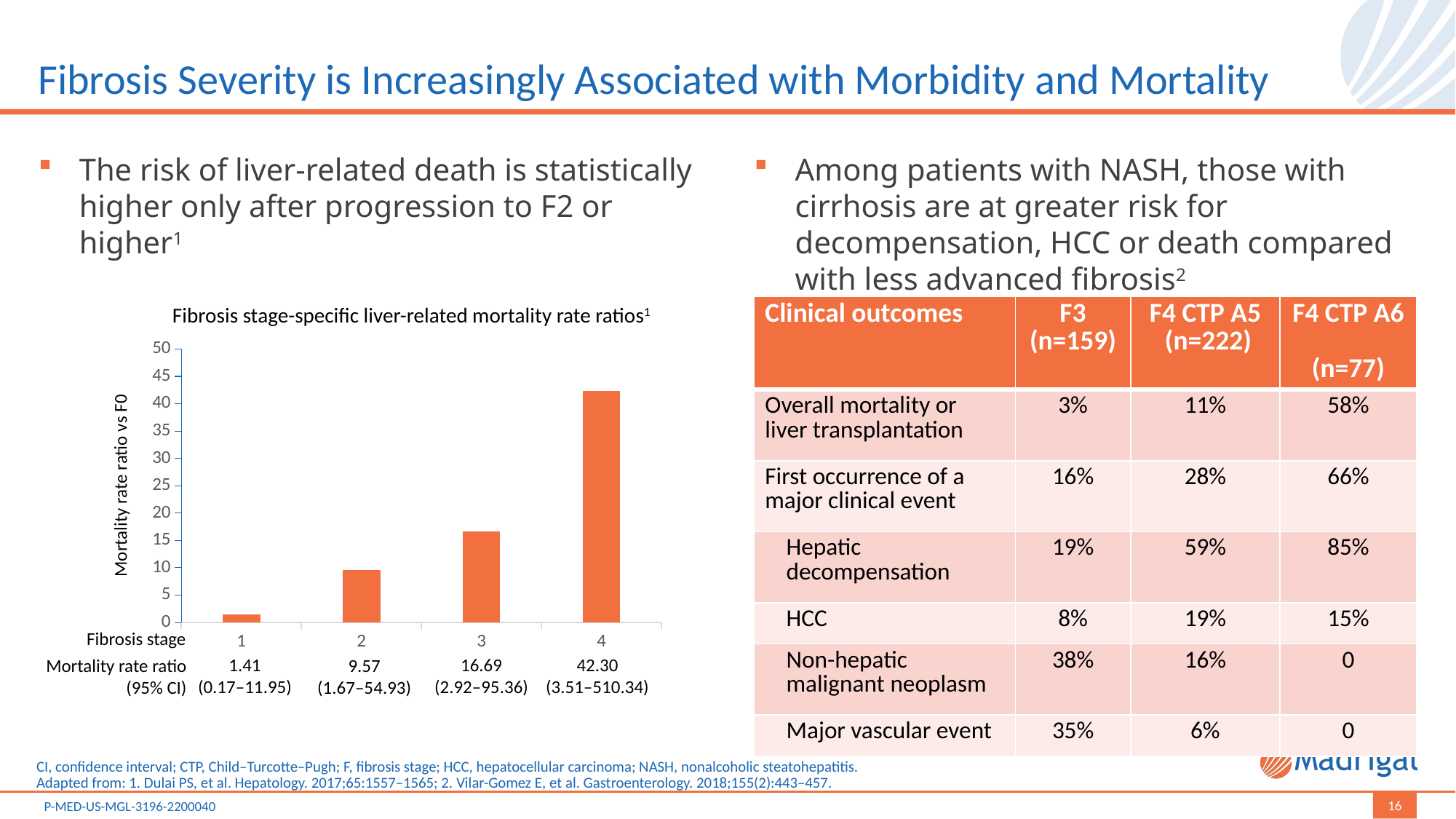
Do the mortality rate ratios rise or fall as fibrosis stage increases from 1 to 4? Rise What type of chart is used to show the fibrosis stage-specific liver-related mortality rate ratios? Bar chart Which fibrosis stage has the lowest mortality rate ratio? 1 What is the mortality rate ratio for fibrosis stage 4? 42.30 Which fibrosis stage has the highest mortality rate ratio? 4 What is the difference between the mortality rate ratios for fibrosis stage 4 and fibrosis stage 3? 25.61 How many fibrosis stages are plotted in the chart? 4 What is the 95% CI shown for fibrosis stage 2? (1.67–54.93) What is the mortality rate ratio for fibrosis stage 1? 1.41 Is the mortality rate ratio for fibrosis stage 4 greater or less than 40? greater What is the mortality rate ratio for fibrosis stage 3? 16.69 Which has a larger mortality rate ratio, fibrosis stage 2 or fibrosis stage 3? Fibrosis stage 3